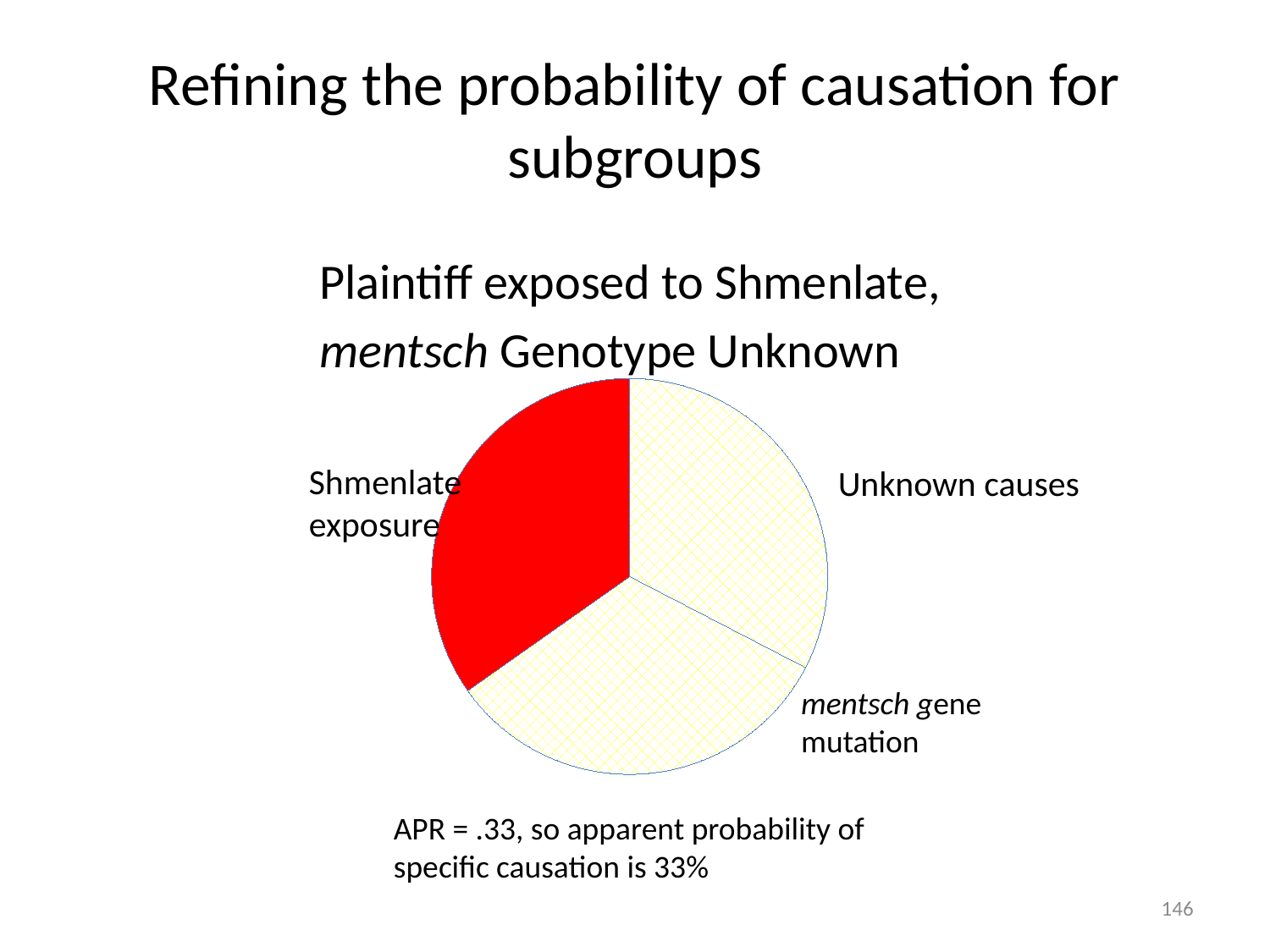
What APR value is stated below the pie chart? .33 What is the title of the pie chart? Plaintiff exposed to Shmenlate, mentsch Genotype Unknown What kind of chart is shown on the slide? pie chart According to the slide, what share of the pie does the Shmenlate exposure slice represent (the apparent probability of specific causation)? 33% How many slices does the pie chart have? 3 Which slice of the pie chart is coloured solid red? Shmenlate exposure Which slice is labelled to the right of the pie chart, at the top? Unknown causes